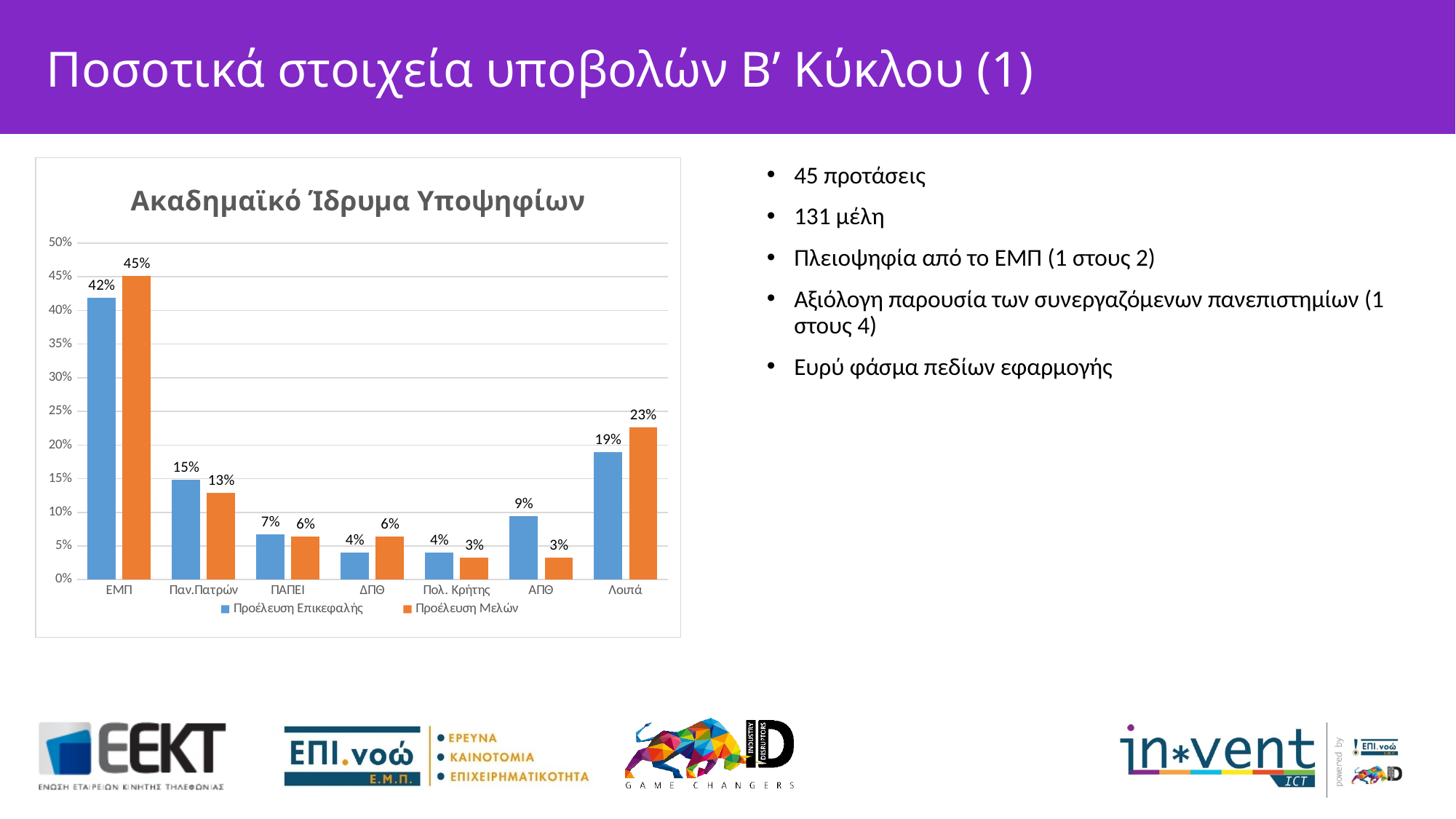
What is the value of Προέλευση Επικεφαλής for ΕΜΠ? 42% How many categories are shown on the x axis? 7 What kind of chart is shown on the slide? bar chart What is the value of Προέλευση Μελών for Λοιπά? 23% Is the value of Προέλευση Επικεφαλής for Λοιπά greater or less than 20%? less Which is larger for ΑΠΘ: Προέλευση Επικεφαλής or Προέλευση Μελών? Προέλευση Επικεφαλής What is the difference between Προέλευση Μελών and Προέλευση Επικεφαλής for ΕΜΠ? 3% What is the title of the chart? Ακαδημαϊκό Ίδρυμα Υποψηφίων What is the value of Προέλευση Μελών for Παν.Πατρών? 13% How many series does the legend list? 2 Which category has the highest value for Προέλευση Μελών? ΕΜΠ Which category has the lowest value for Προέλευση Επικεφαλής? ΔΠΘ and Πολ. Κρήτης (both 4%)